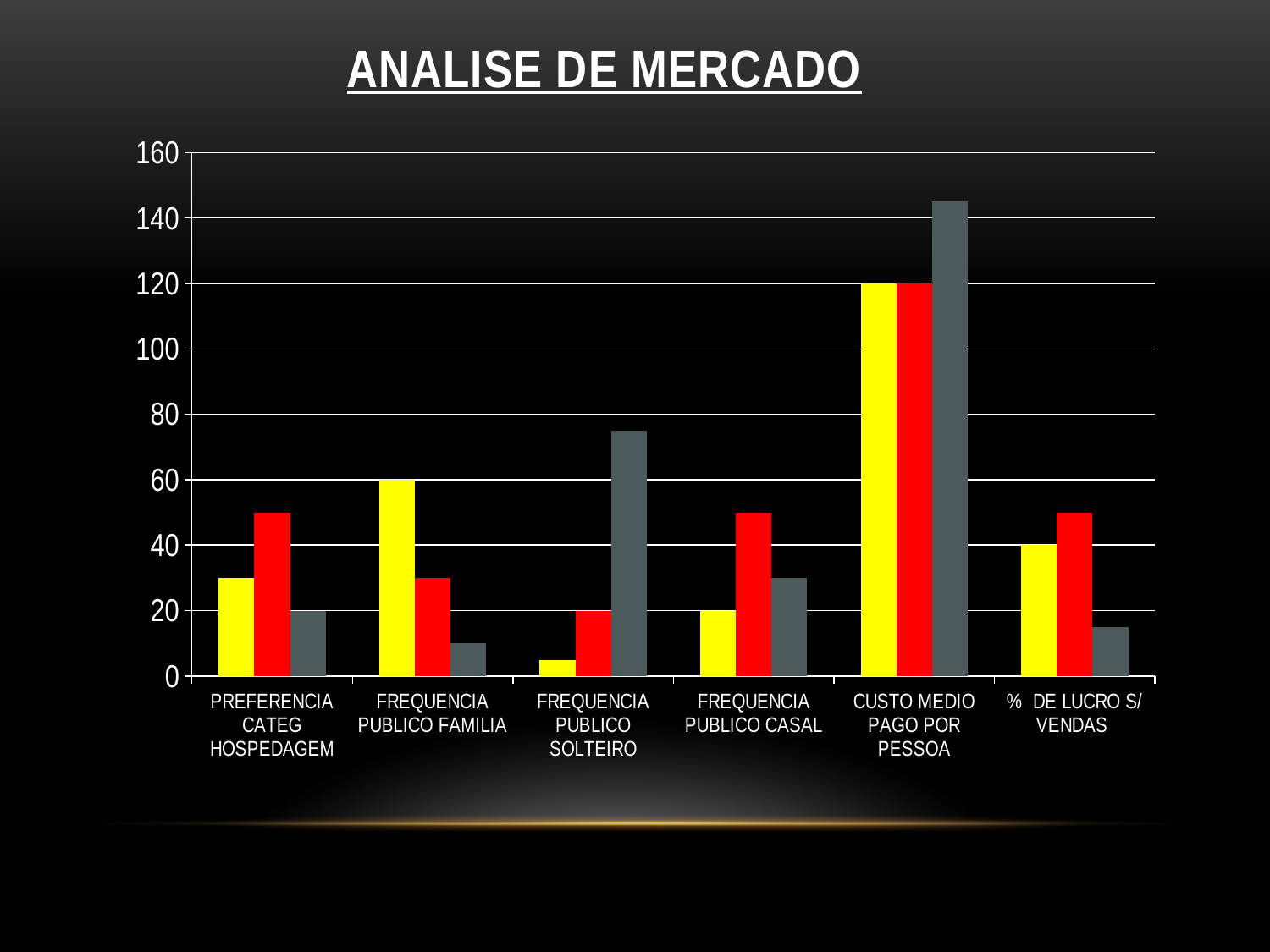
Is the grey bar for FREQUENCIA PUBLICO SOLTEIRO greater or less than 60? greater Is the grey bar for CUSTO MEDIO PAGO POR PESSOA greater or less than 140? greater What is the value of the yellow bar for % DE LUCRO S/ VENDAS? 40 What is the value of the yellow bar for FREQUENCIA PUBLICO FAMILIA? 60 How many categories are shown along the x axis? 6 Which bar is the lowest for FREQUENCIA PUBLICO SOLTEIRO? the yellow bar What is the value of the yellow bar for CUSTO MEDIO PAGO POR PESSOA? 120 What type of chart is shown on the slide? bar chart What is the title of the chart? ANALISE DE MERCADO Which is larger for FREQUENCIA PUBLICO FAMILIA, the yellow bar or the grey bar? the yellow bar Which category has the tallest bar in the chart? CUSTO MEDIO PAGO POR PESSOA How many bars are shown for each category? 3